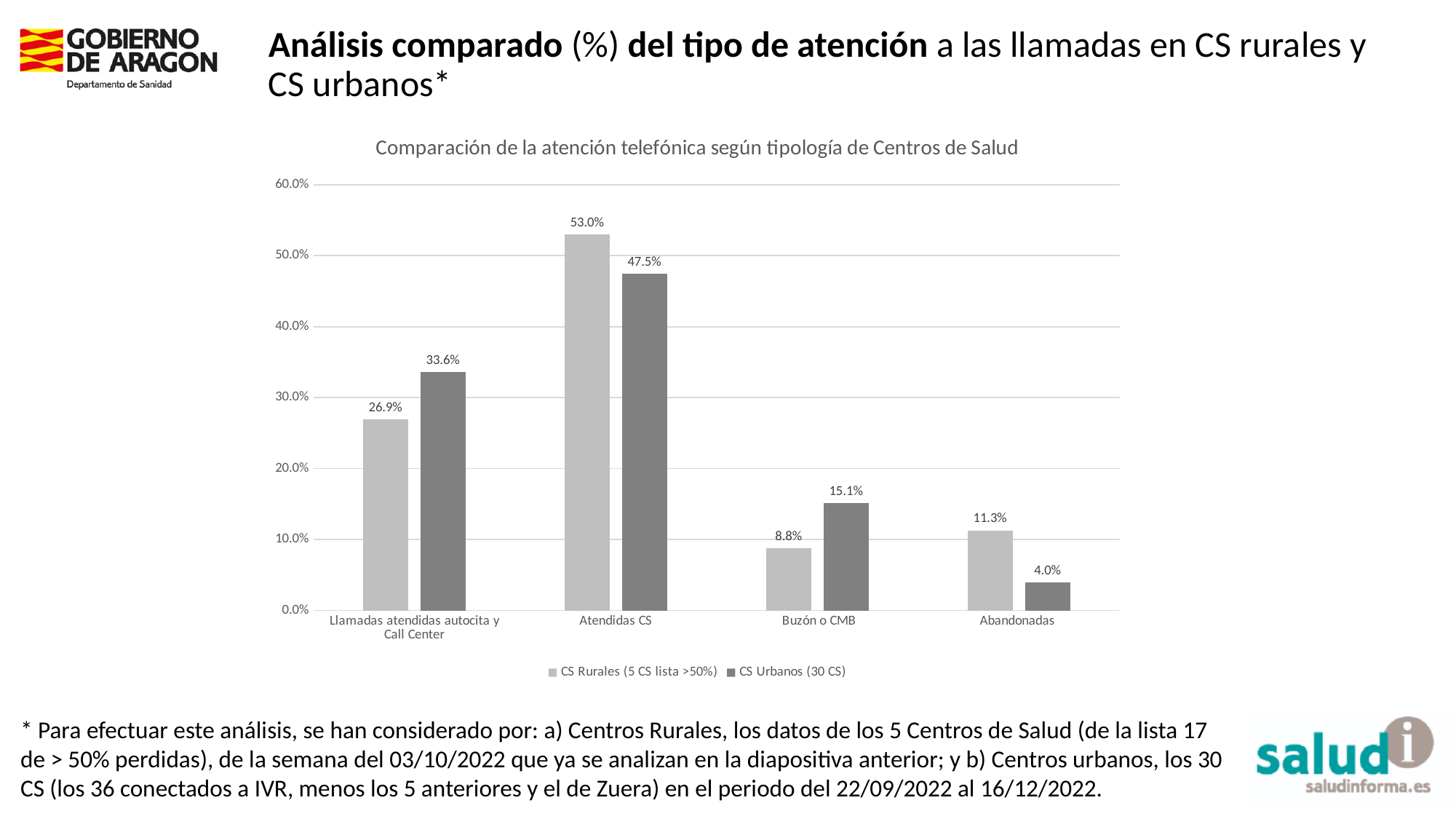
What is the title of the chart? Comparación de la atención telefónica según tipología de Centros de Salud What is the value for CS Urbanos in the Llamadas atendidas autocita y Call Center category? 33.6% What is the value for CS Rurales in the Buzón o CMB category? 8.8% What is the difference between CS Rurales and CS Urbanos in the Atendidas CS category? 5.5% Which category has the highest value for CS Urbanos? Atendidas CS What is the value for CS Rurales in the Atendidas CS category? 53.0% Which category has the lowest value for CS Rurales? Buzón o CMB How many categories are shown on the x axis? 4 What is the value for CS Urbanos in the Abandonadas category? 4.0% What kind of chart is shown on the slide? Bar chart How many series does the legend list? 2 Which is larger in the Abandonadas category, CS Rurales or CS Urbanos? CS Rurales